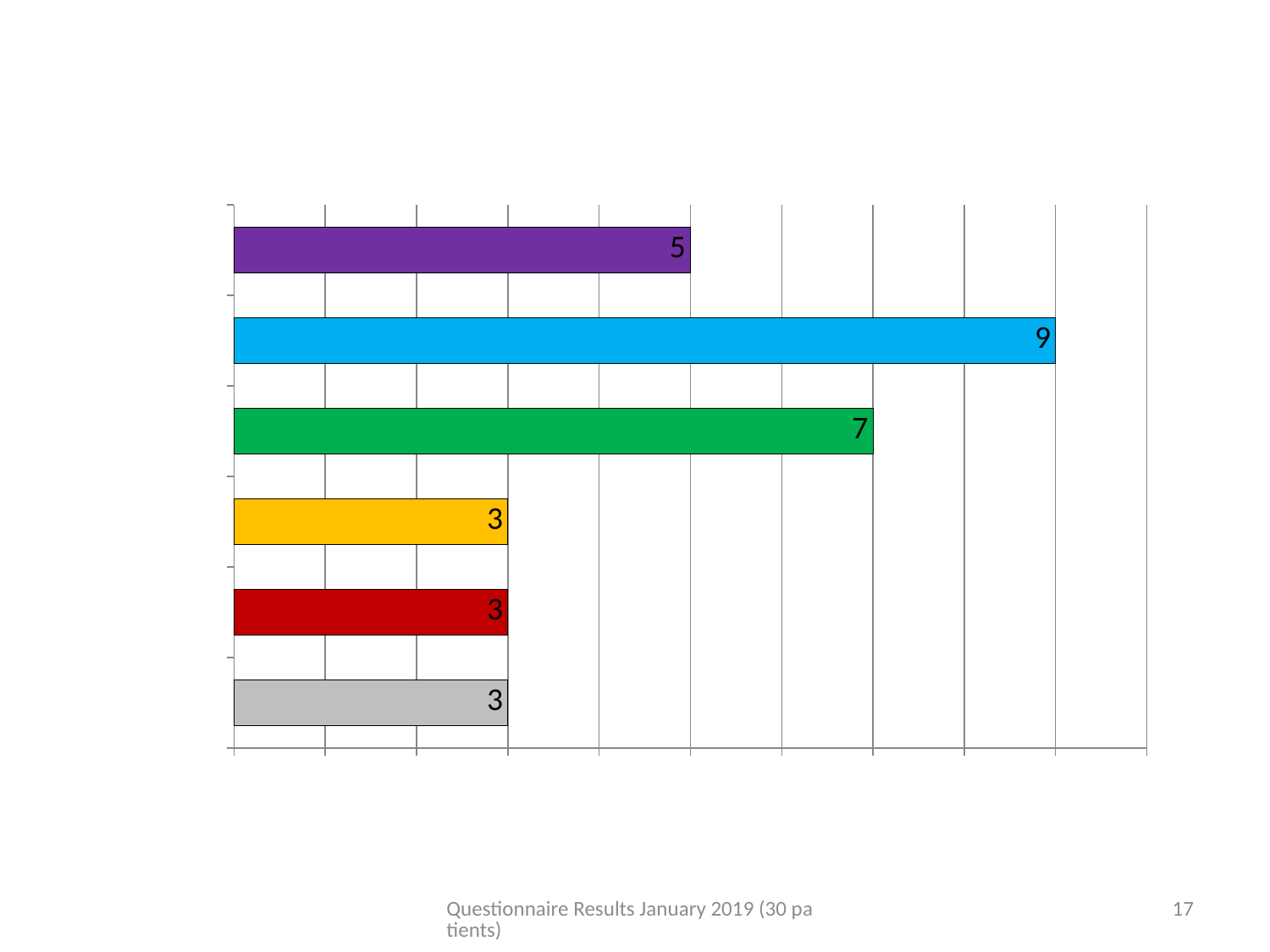
What is the difference between the value of the light blue bar and the value of the green bar? 2 What is the lowest value shown on any bar in the chart? 3 How many bars in the chart have a value of 3? 3 What is the value shown on the grey bar at the bottom of the chart? 3 Which is larger, the value of the purple bar or the value of the green bar? the green bar What is the value shown on the purple bar at the top of the chart? 5 What kind of chart is shown on the slide? bar chart What is the value shown on the green bar? 7 What is the value shown on the light blue bar? 9 How many bars are plotted in the chart? 6 Which bar has the highest value in the chart? the light blue bar What is the value shown on the yellow bar? 3